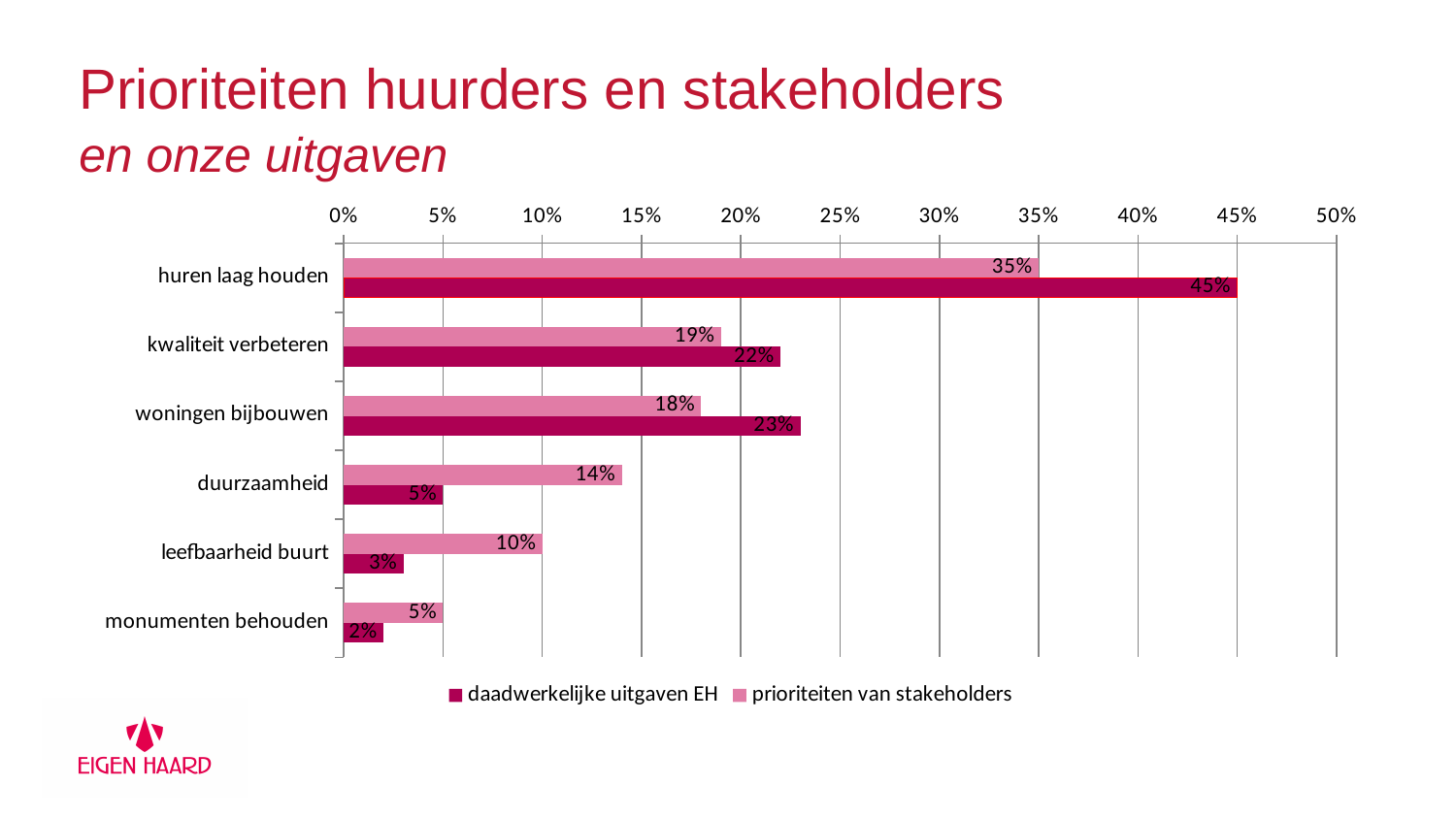
What is the difference between 'prioriteiten van stakeholders' and 'daadwerkelijke uitgaven EH' for 'duurzaamheid'? 9% What kind of chart is shown on the slide? bar chart What is the value of 'daadwerkelijke uitgaven EH' for 'leefbaarheid buurt'? 3% What is the value of 'daadwerkelijke uitgaven EH' for 'huren laag houden'? 45% Which category has the lowest value for 'daadwerkelijke uitgaven EH'? monumenten behouden What is the title of the slide? Prioriteiten huurders en stakeholders en onze uitgaven How many series does the legend list? 2 How many categories are shown on the chart? 6 What is the difference between 'daadwerkelijke uitgaven EH' and 'prioriteiten van stakeholders' for 'huren laag houden'? 10% Which category has the highest value for 'prioriteiten van stakeholders'? huren laag houden What is the value of 'prioriteiten van stakeholders' for 'duurzaamheid'? 14% For 'woningen bijbouwen', which is larger: 'daadwerkelijke uitgaven EH' or 'prioriteiten van stakeholders'? daadwerkelijke uitgaven EH